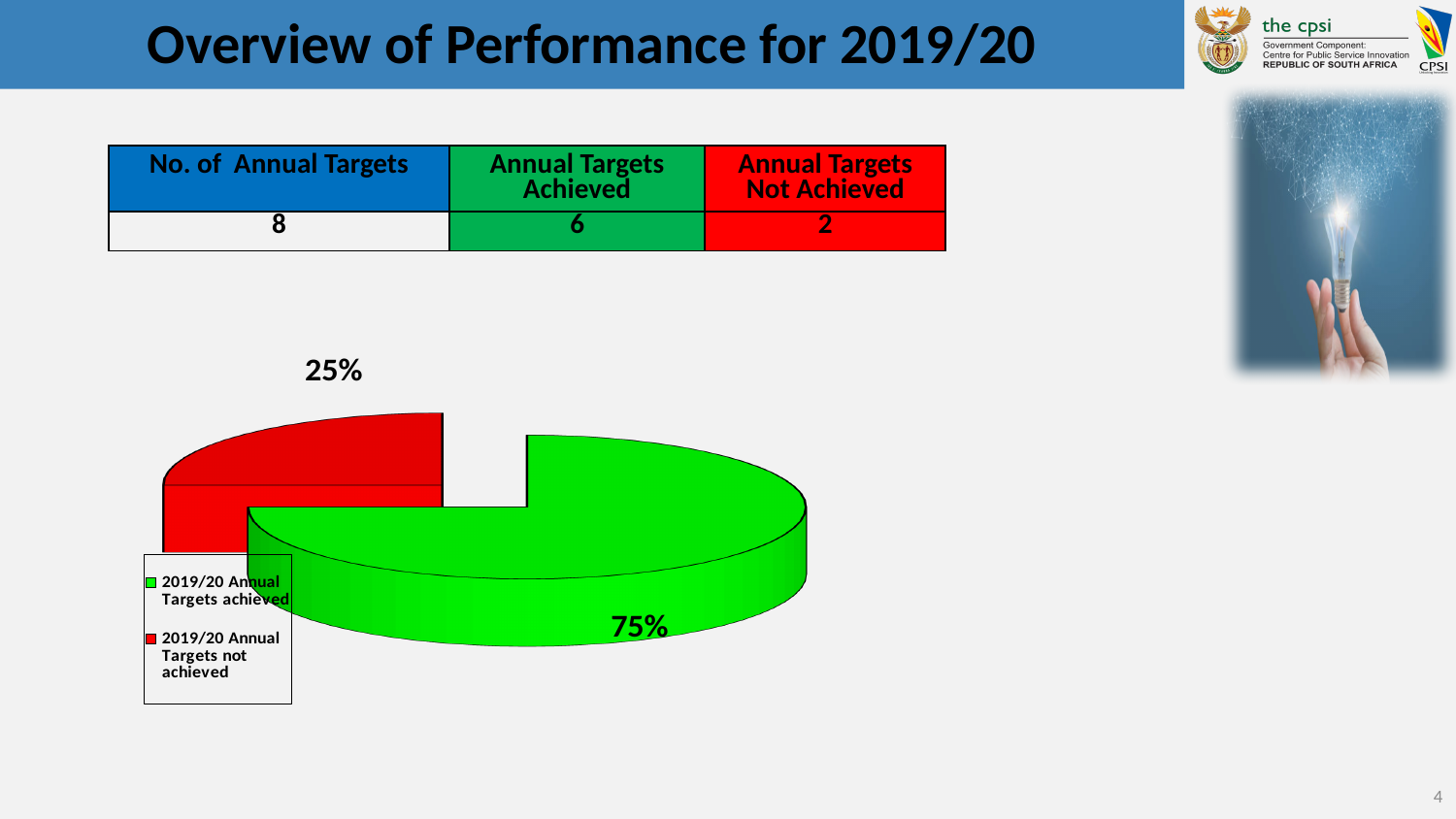
What colour is the slice for 2019/20 Annual Targets not achieved? Red Which slice of the pie is the smallest? 2019/20 Annual Targets not achieved Which slice of the pie is the largest? 2019/20 Annual Targets achieved What colour is the slice for 2019/20 Annual Targets achieved? Green What is the difference in percentage points between the achieved and not achieved slices? 50 What share of the pie is labelled for 2019/20 Annual Targets not achieved? 25% How many entries does the legend list? 2 Which is larger: the share for targets achieved or the share for targets not achieved? Targets achieved What kind of chart is shown on the slide? Pie chart How many slices does the pie chart have? 2 What share of the pie is labelled for 2019/20 Annual Targets achieved? 75%